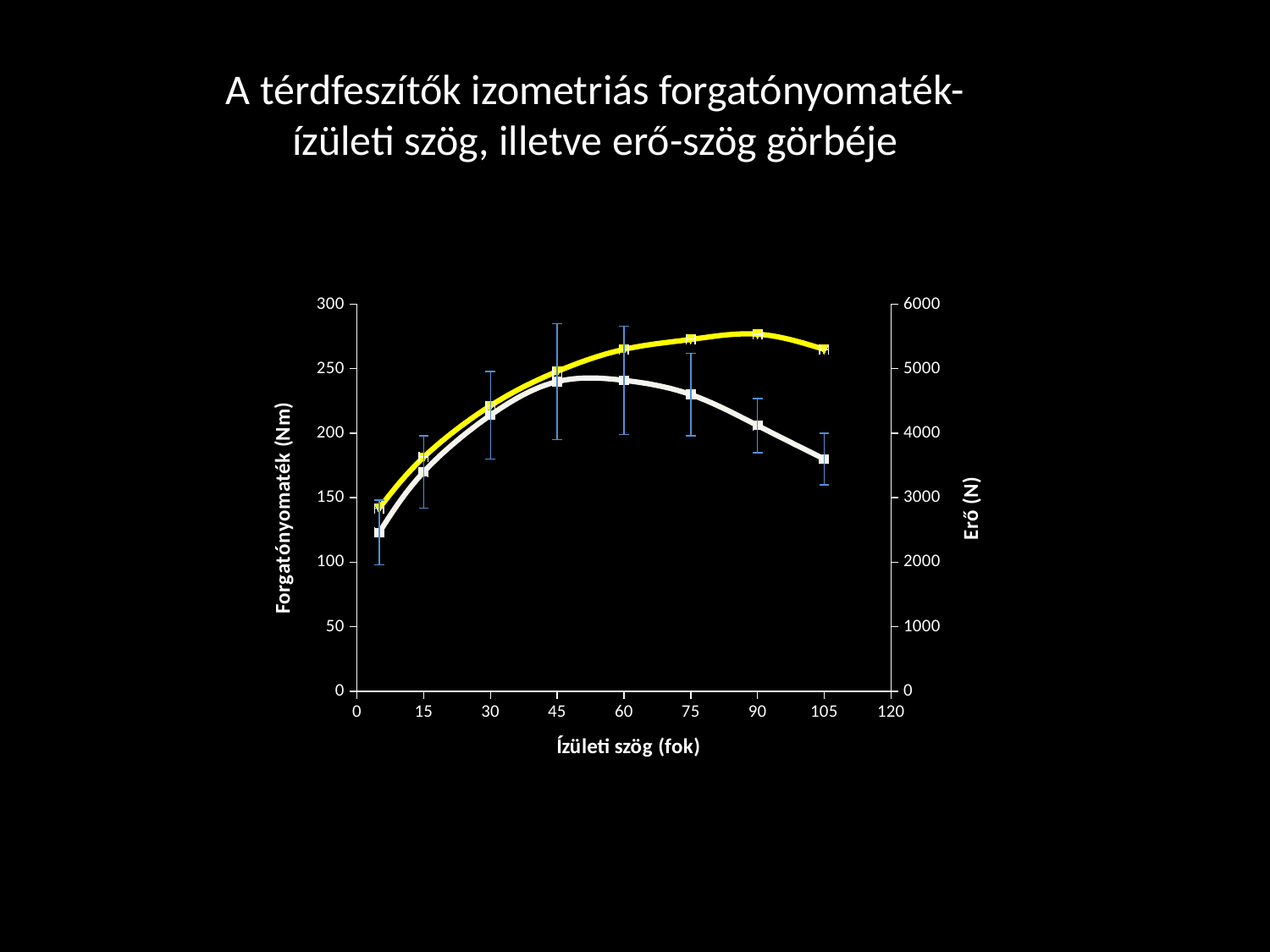
Is the torque value (white curve) at 60 degrees greater or less than 200 Nm? greater At which joint angle is the torque (white curve) lowest? 5 Which has the larger torque on the white curve: 5 degrees or 105 degrees? 105 degrees Is the torque value (white curve) at 5 degrees greater or less than 150 Nm? less What is the title of the horizontal axis? Ízületi szög (fok) Does the torque (white curve) rise or fall between 75 and 105 degrees? fall Is the force value (yellow curve) at 15 degrees greater or less than 3000 N? greater What kind of chart is shown on the slide? Line chart What is the title of the left vertical axis? Forgatónyomaték (Nm) How many curves are plotted on the chart? 2 How many data points does the white torque curve have? 8